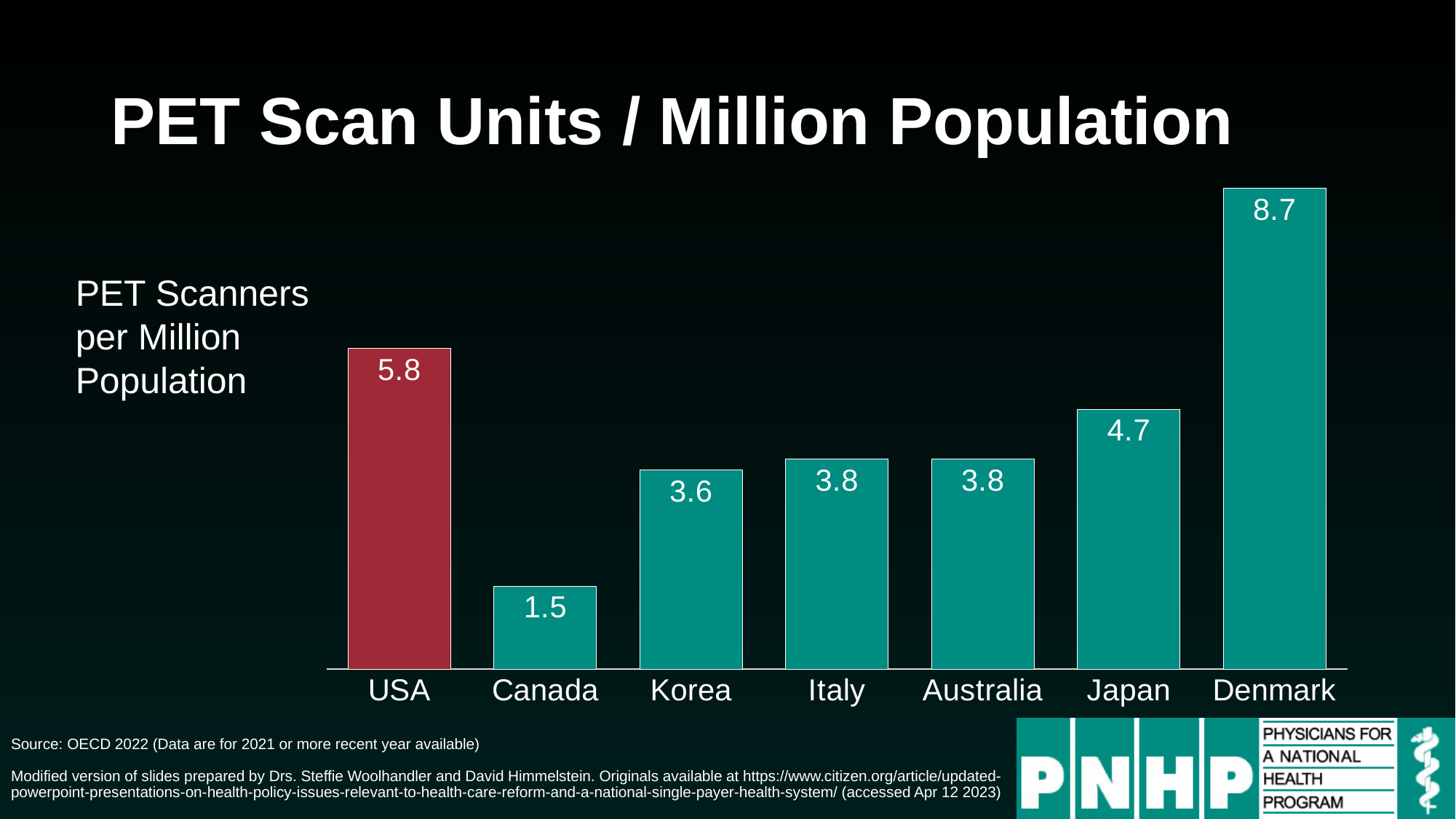
What is the value for the USA? 5.8 Which country has the lowest number of PET scan units per million population? Canada What is the value for Japan? 4.7 What is the difference between the values for the USA and Canada? 4.3 Which is larger, the value for Korea or the value for Japan? Japan Which two countries have the same value of 3.8? Italy and Australia What is the difference between the values for Denmark and the USA? 2.9 Which country has the highest number of PET scan units per million population? Denmark What kind of chart is shown on the slide? Bar chart What is the value for Canada? 1.5 Which country's bar is coloured red rather than teal? USA How many countries are shown in the chart? 7